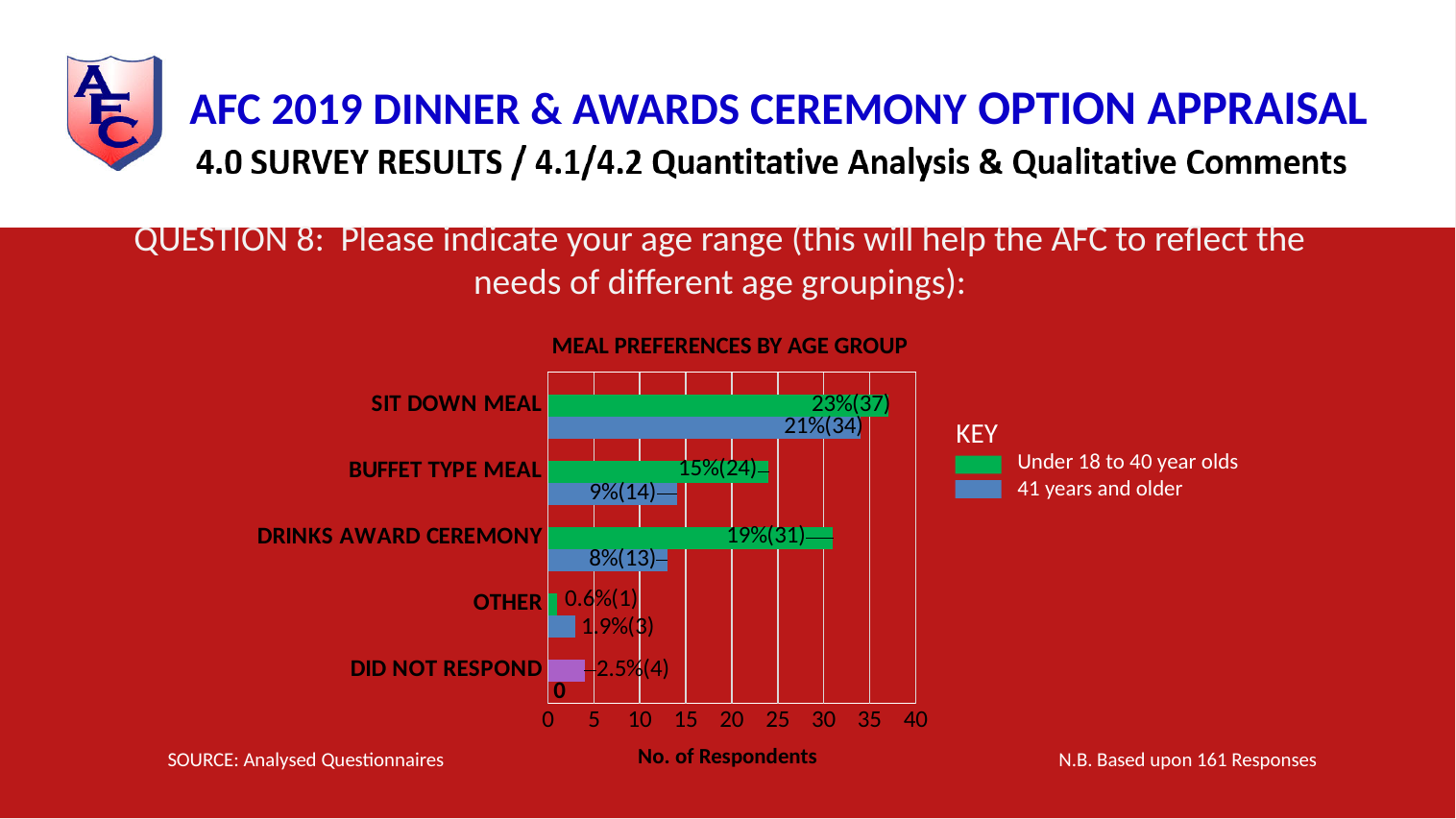
Which category has the lowest number of respondents for Under 18 to 40 year olds? OTHER How many more respondents chose DRINKS AWARD CEREMONY among Under 18 to 40 year olds than among 41 years and older? 18 What is the chart title? MEAL PREFERENCES BY AGE GROUP How many series does the key list? 2 What is the value for DRINKS AWARD CEREMONY for Under 18 to 40 year olds? 19%(31) What is the value for SIT DOWN MEAL for Under 18 to 40 year olds? 23%(37) What kind of chart is shown on the slide? bar chart What is the value for OTHER for 41 years and older? 1.9%(3) What is the value for BUFFET TYPE MEAL for 41 years and older? 9%(14) How many categories are shown on the vertical axis of the chart? 5 For BUFFET TYPE MEAL, which age group has more respondents: Under 18 to 40 year olds or 41 years and older? Under 18 to 40 year olds Which category has the highest number of respondents for Under 18 to 40 year olds? SIT DOWN MEAL